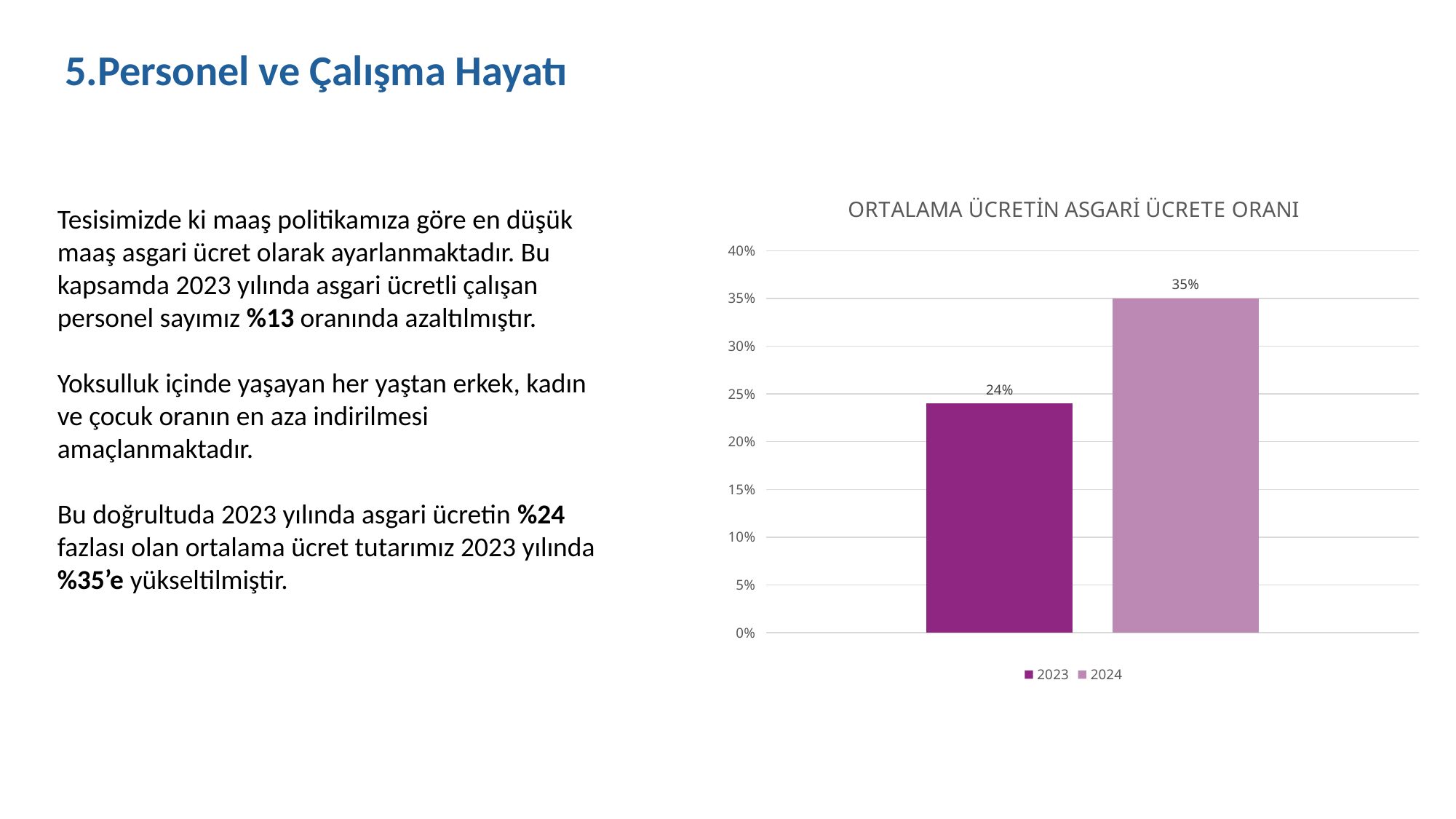
Is the value for 2023 greater or less than 25%? less What kind of chart is shown on the slide? Bar chart What is the value for 2024 in the chart? 35% Is the value for 2024 larger than the value for 2023? Yes What is the difference between the 2024 and 2023 values in the chart? 11% Which year has the lower value in the chart? 2023 What is the title of the chart? ORTALAMA ÜCRETİN ASGARİ ÜCRETE ORANI Which year has the higher value in the chart? 2024 Is the value for 2024 greater or less than 30%? greater How many series does the legend list? 2 What is the value for 2023 in the chart? 24% How many bars are plotted in the chart? 2